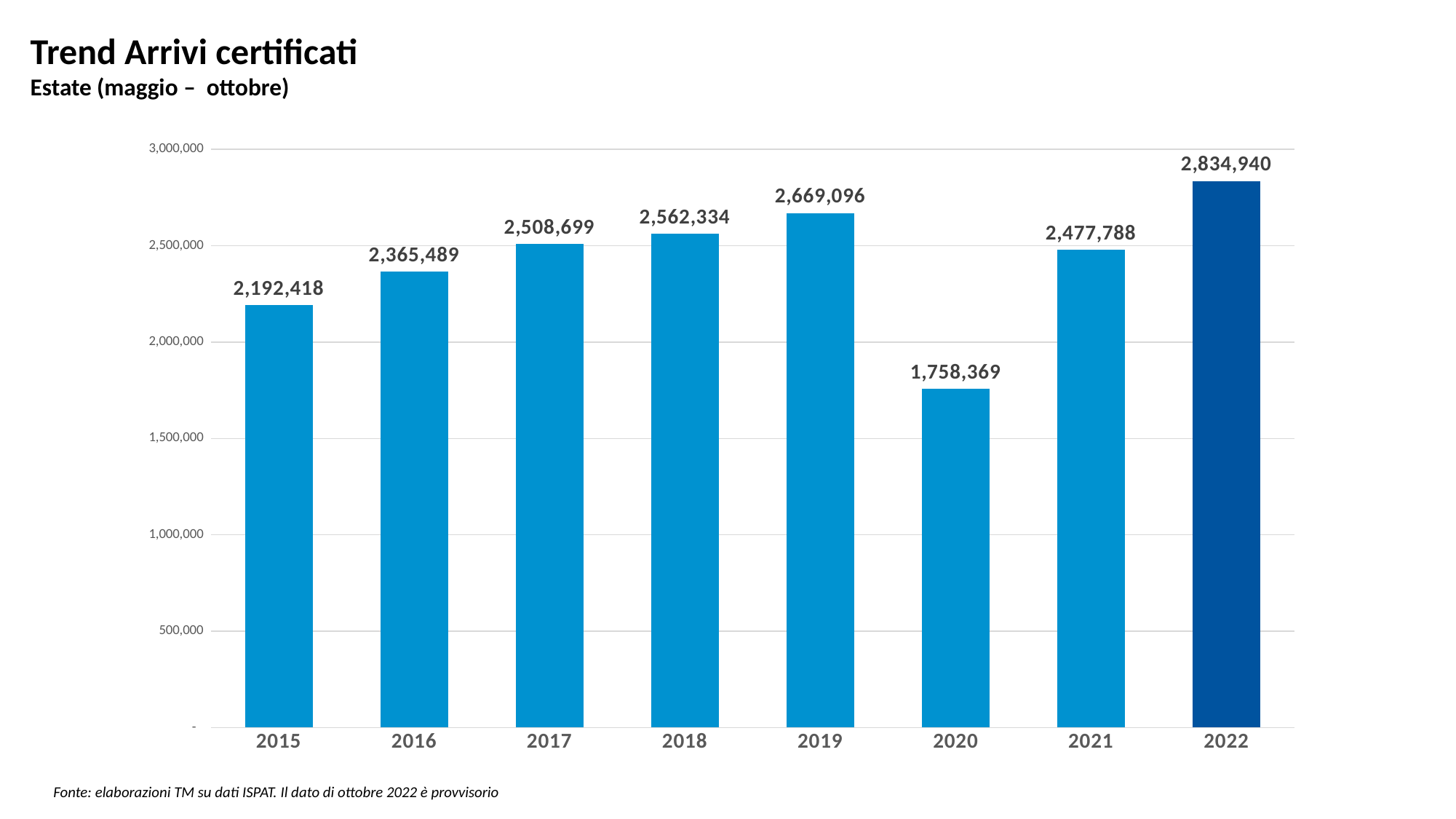
Is the value for 2020 greater or less than 2,000,000? less What is the difference between the values for 2019 and 2020? 910,727 Do the values rise or fall from 2015 to 2019? rise How many years are shown on the x axis? 8 What is the value for 2019? 2,669,096 Which year has the highest value? 2022 Which is larger, the value for 2018 or the value for 2021? 2018 What kind of chart is shown on the slide? bar chart What is the value for 2020? 1,758,369 Which year has the lowest value? 2020 What is the difference between the values for 2022 and 2021? 357,152 What is the value for 2015? 2,192,418